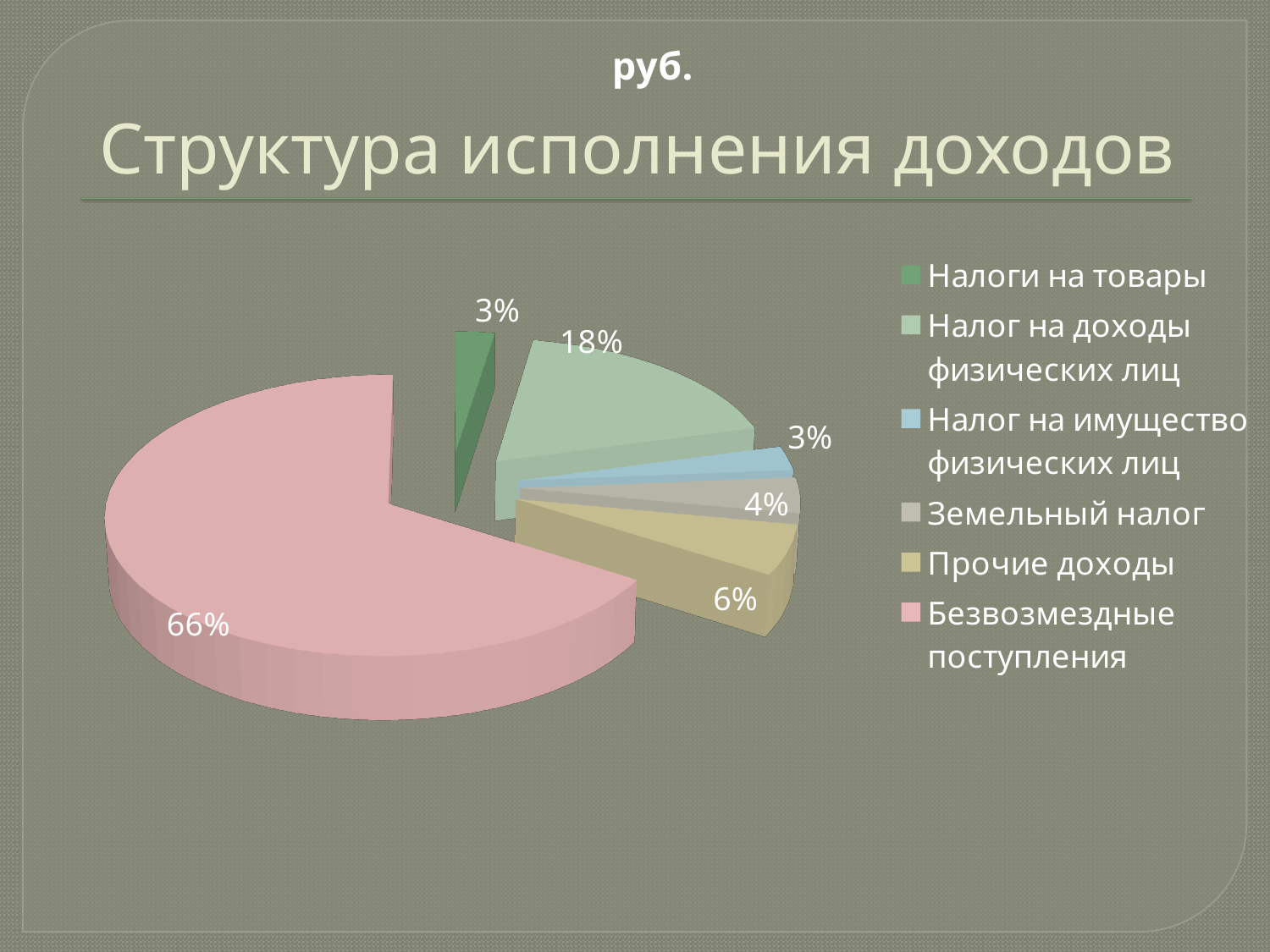
What is the value shown for Налог на имущество физических лиц? 3% What share of the pie does Безвозмездные поступления take? 66% How many entries does the legend list? 6 What is the value shown for Налог на доходы физических лиц? 18% Which category has the largest share of the pie? Безвозмездные поступления How many slices does the pie chart have? 6 What type of chart is shown on the slide? pie chart What is the value shown for Прочие доходы? 6% Which is larger, the share of Прочие доходы or the share of Земельный налог? Прочие доходы What is the value shown for Земельный налог? 4% What is the difference between the shares of Безвозмездные поступления and Налог на доходы физических лиц? 48% What is the title of the slide? Структура исполнения доходов